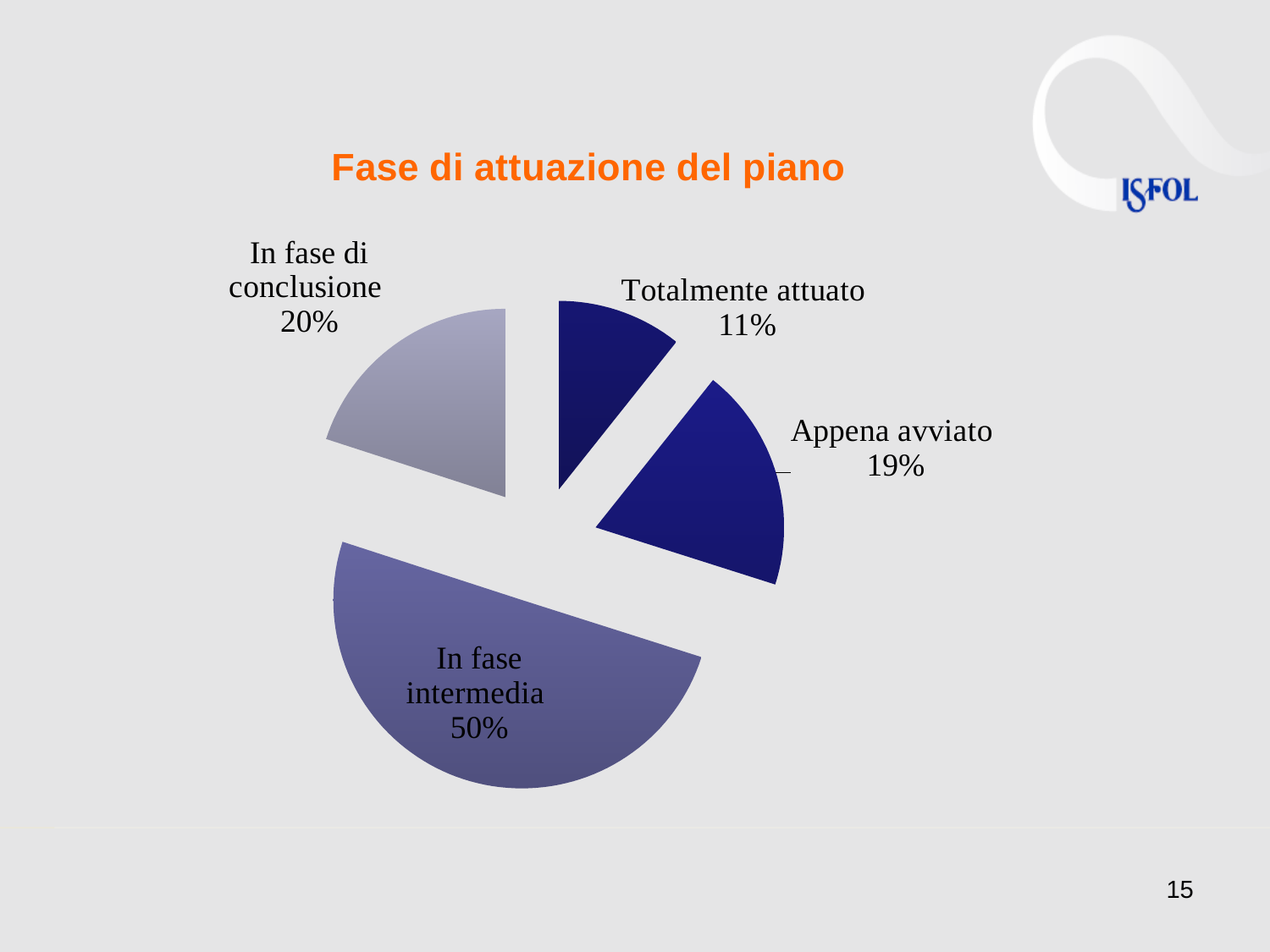
What is the share for 'In fase di conclusione'? 20% What is the title of the chart? Fase di attuazione del piano How many slices does the pie chart have? 4 What is the share for 'Totalmente attuato'? 11% Which category has the largest slice of the pie? In fase intermedia What is the share for 'In fase intermedia'? 50% What is the difference in percentage points between 'Appena avviato' and 'Totalmente attuato'? 8 What kind of chart is shown on the slide? Pie chart What is the share for 'Appena avviato'? 19% Which is larger, 'In fase di conclusione' or 'Totalmente attuato'? In fase di conclusione Which category has the smallest slice of the pie? Totalmente attuato What is the difference in percentage points between 'In fase intermedia' and 'In fase di conclusione'? 30